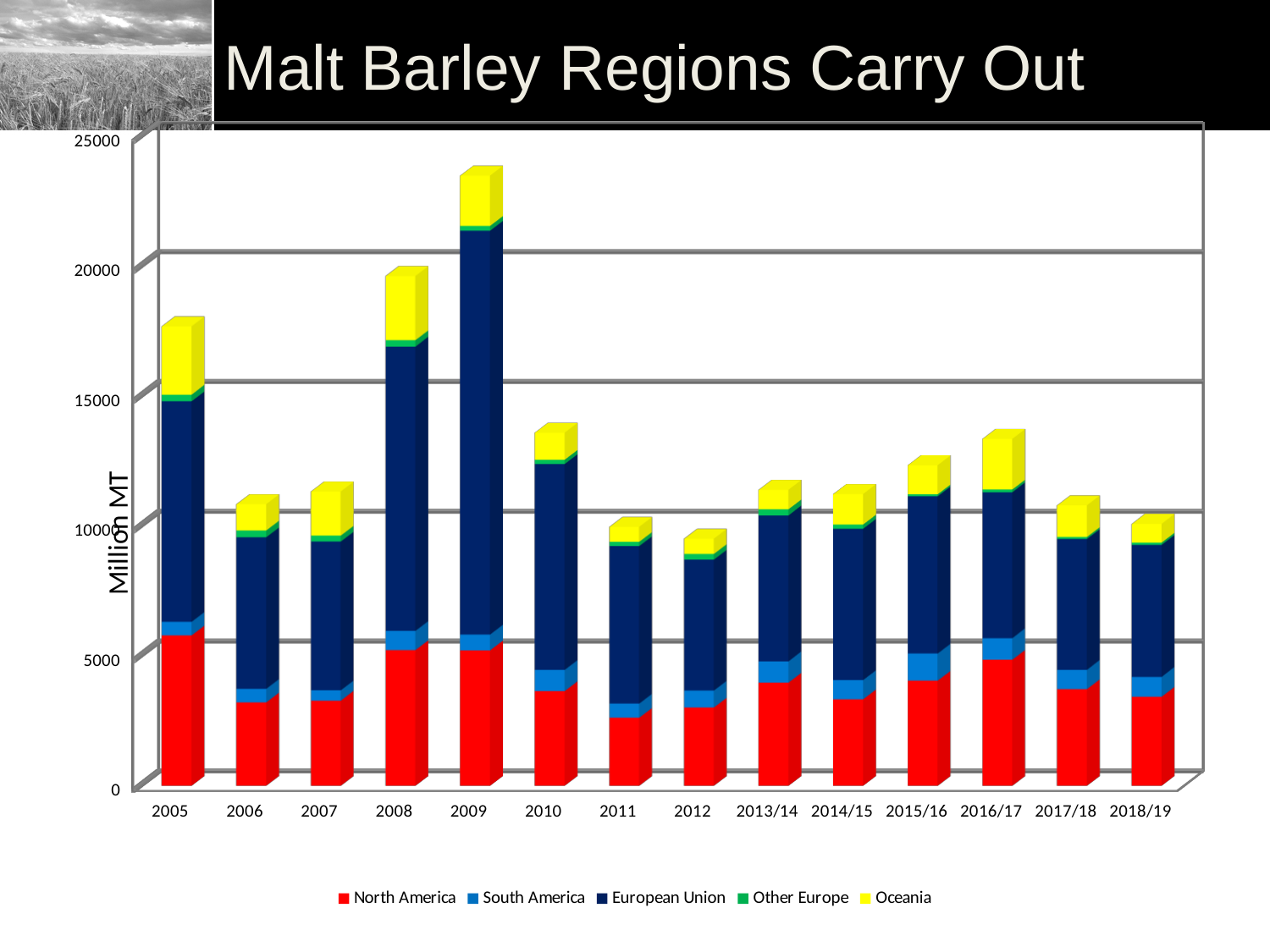
How many series does the legend list? 5 Do the total stacked values rise or fall from 2009 to 2012? fall Which colour represents Oceania in the legend? Yellow Is the total stacked value for 2006 greater or less than 10000? greater Which year has the tallest stacked bar? 2009 Is the total stacked value for 2005 greater or less than 15000? greater How many year categories are shown on the x axis? 14 Is the total stacked value for 2010 greater or less than 15000? less Which year has the larger total stacked bar, 2008 or 2010? 2008 What kind of chart is shown on the slide? Stacked bar chart What is the title of the chart? Malt Barley Regions Carry Out